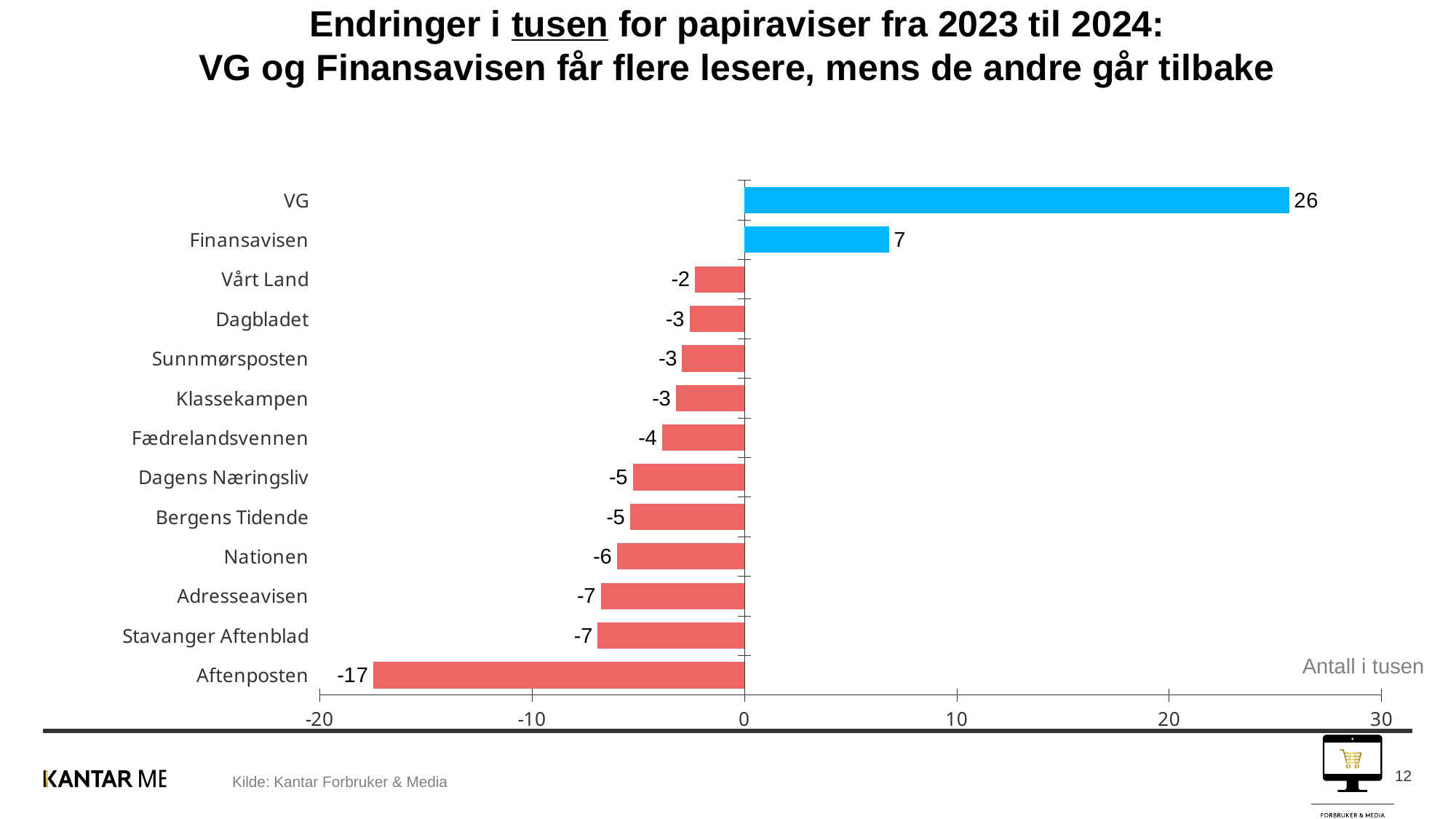
What is the value for Aftenposten? -17 Which newspaper has the highest value? VG What is the value for Nationen? -6 What kind of chart is shown on the slide? Bar chart What label is shown next to the horizontal axis? Antall i tusen Which newspaper has the lowest value? Aftenposten How many newspapers are shown in the chart? 13 What is the value for Finansavisen? 7 What is the value for VG? 26 Which has a larger value, Fædrelandsvennen or Dagens Næringsliv? Fædrelandsvennen What is the difference between the values for VG and Finansavisen? 19 How many newspapers have a positive value? 2